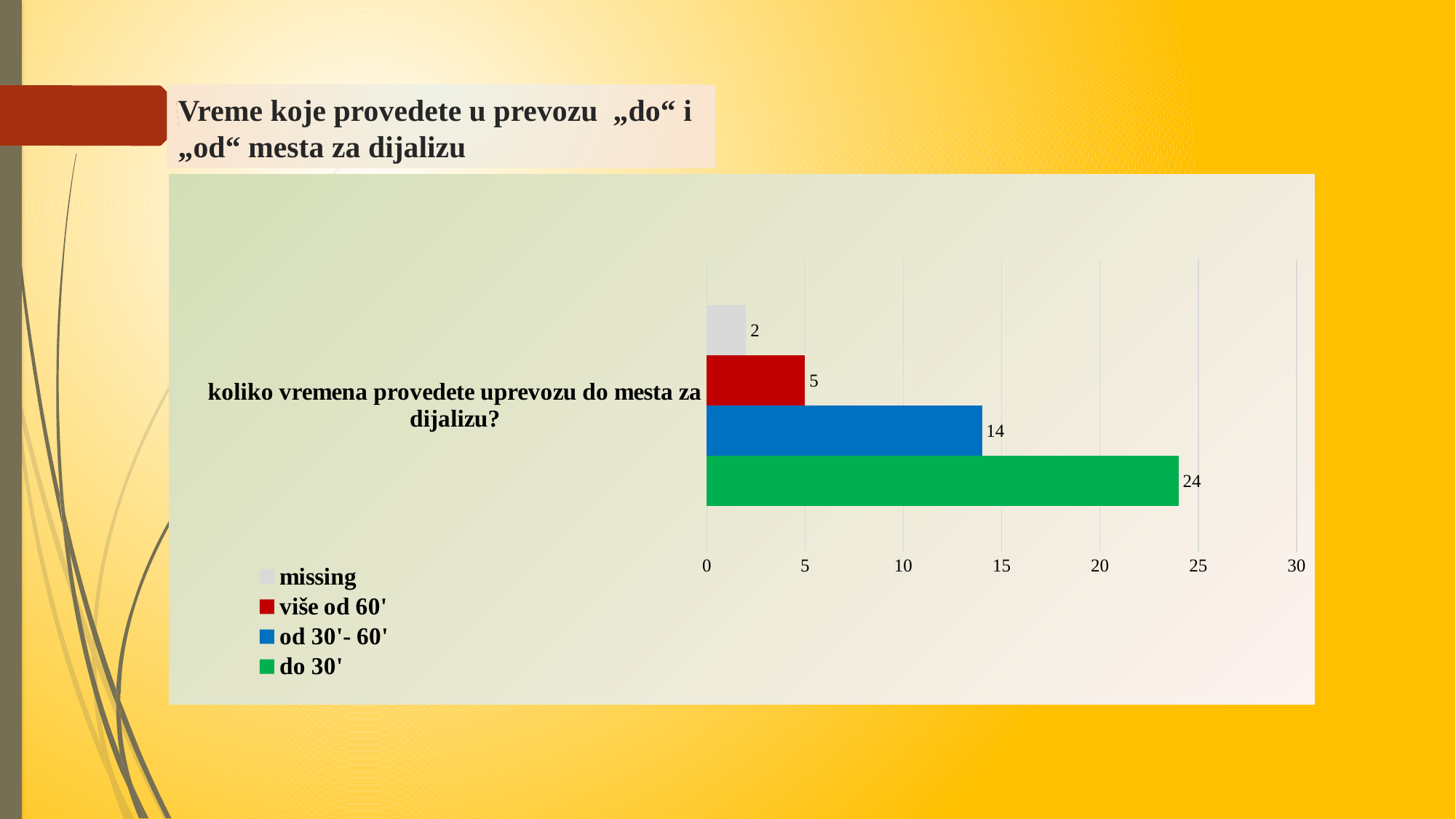
What is the value for the 'missing' series? 2 What is the value for the 'do 30'' series? 24 How many series does the legend list? 4 What kind of chart is shown on the slide? bar chart Which series has the lowest value? missing What is the value for the 'više od 60'' series? 5 What colour is the bar for 'do 30''? green What is the difference between the values for 'do 30'' and 'od 30'- 60''? 10 Which series has the highest value? do 30' Is the value for 'od 30'- 60'' greater or less than 10? greater Which is larger, the value for 'više od 60'' or the value for 'missing'? više od 60' What is the value for the 'od 30'- 60'' series? 14